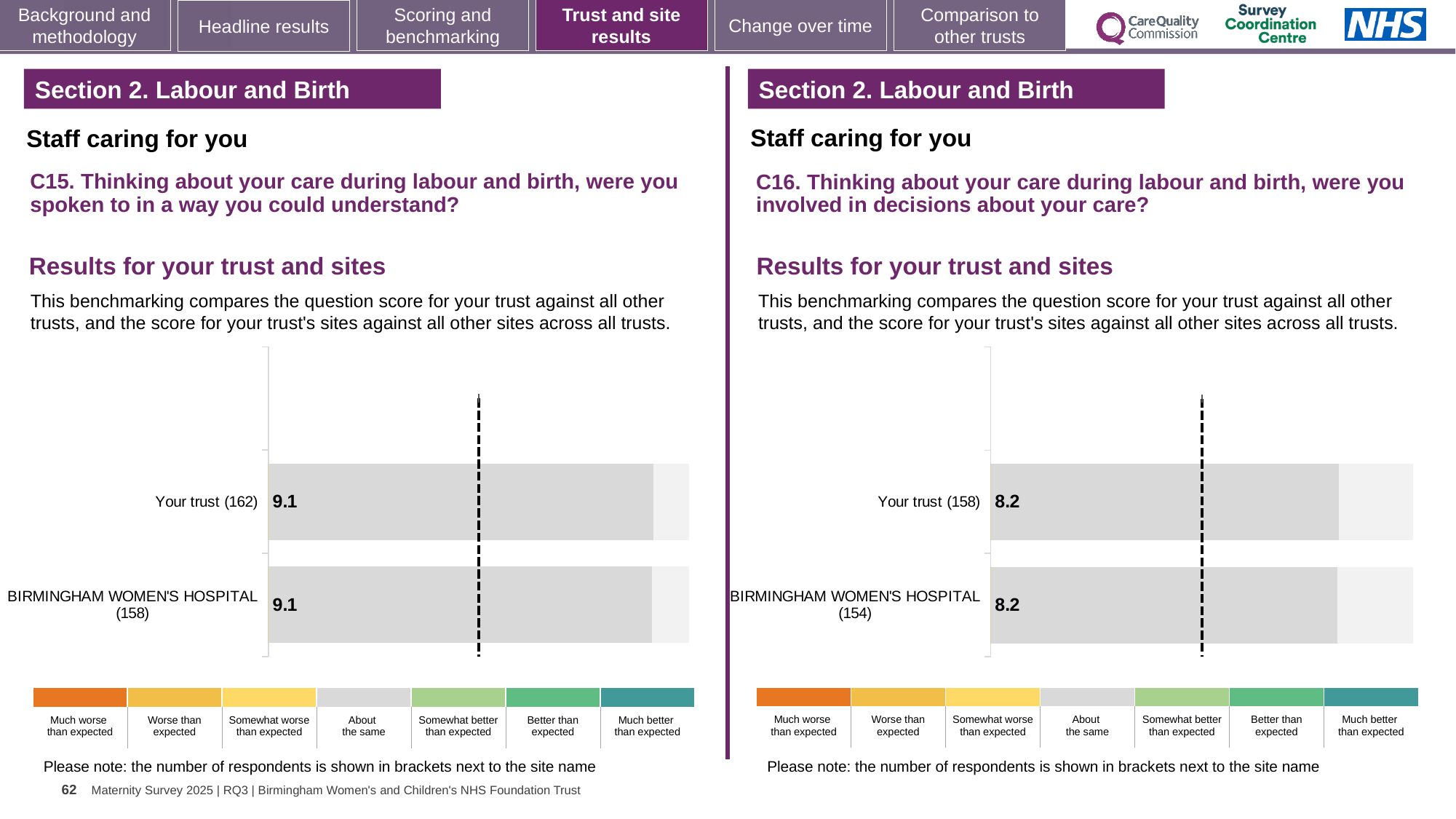
On the left chart (C15), what is the score for Your trust? 9.1 On the right chart (C16), how many respondents are shown in brackets for BIRMINGHAM WOMEN'S HOSPITAL? 154 How many bars are plotted on the right chart (C16)? 2 On the left chart (C15), how many respondents are shown in brackets for Your trust? 162 On the right chart (C16), what is the score for Your trust? 8.2 On the left chart (C15), what is the score for BIRMINGHAM WOMEN'S HOSPITAL? 9.1 How many bars are plotted on the left chart (C15)? 2 On the right chart (C16), what is the difference between the Your trust score and the BIRMINGHAM WOMEN'S HOSPITAL score? 0 On the left chart (C15), what is the difference between the Your trust score and the BIRMINGHAM WOMEN'S HOSPITAL score? 0 Is the Your trust score on the left chart (C15) larger or smaller than the Your trust score on the right chart (C16)? Larger What type of chart is used on the left (C15)? Bar chart On the right chart (C16), what is the score for BIRMINGHAM WOMEN'S HOSPITAL? 8.2